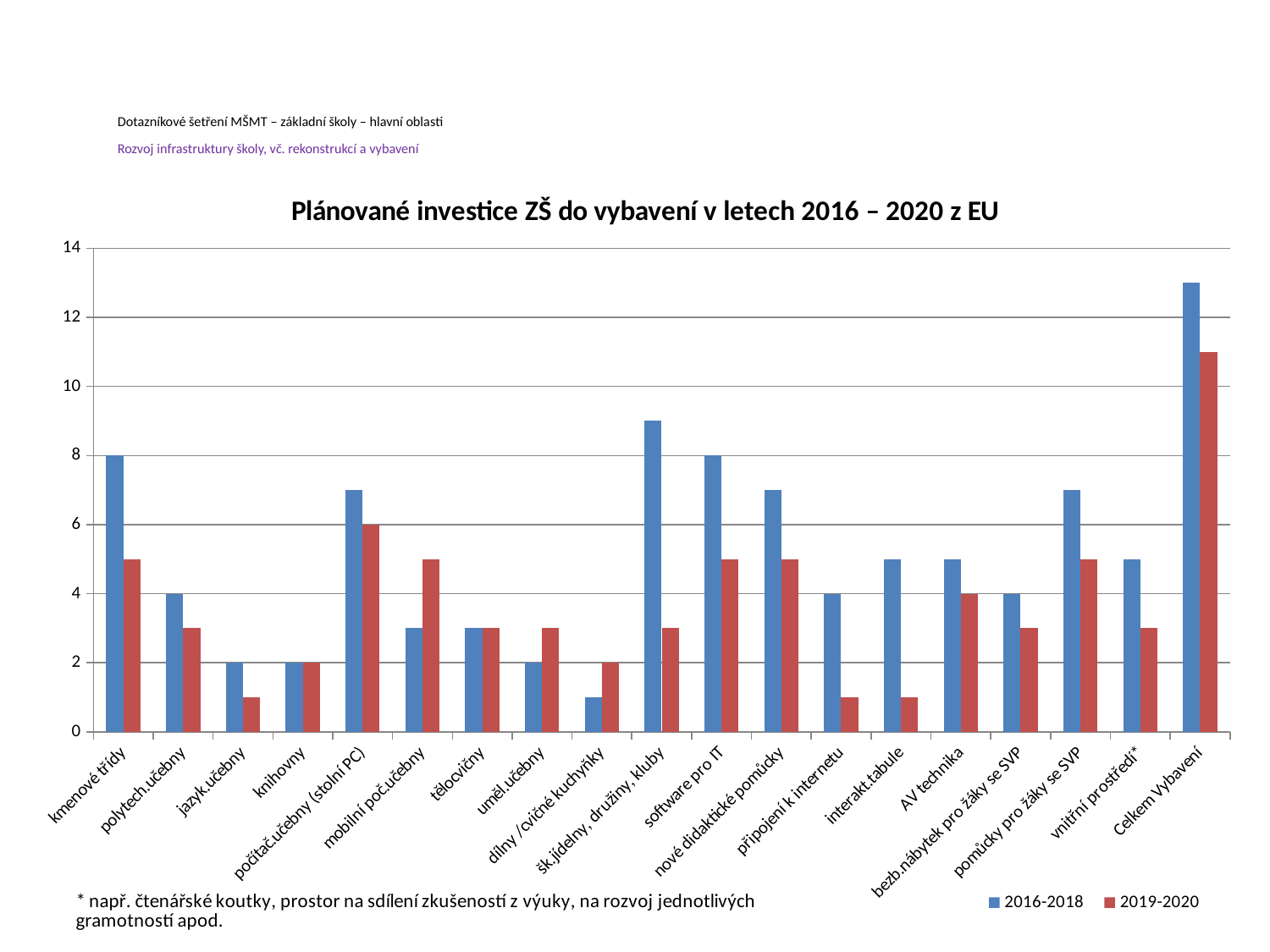
What kind of chart is shown on the slide? bar chart What is the value for kmenové třídy in the 2016-2018 series? 8 What is the difference between the 2016-2018 values for kmenové třídy and knihovny? 6 How many series does the legend list? 2 What is the title of the chart? Plánované investice ZŠ do vybavení v letech 2016 – 2020 z EU How many categories are shown on the x axis? 19 What is the value for počítač.učebny (stolní PC) in the 2019-2020 series? 6 Which category has the highest value in the 2016-2018 series? Celkem Vybavení Which category has the lowest value in the 2016-2018 series? dílny /cvičné kuchyňky What is the value for knihovny in the 2019-2020 series? 2 Is the value for Celkem Vybavení in the 2019-2020 series greater or less than 10? greater For software pro IT, which series has the larger value, 2016-2018 or 2019-2020? 2016-2018